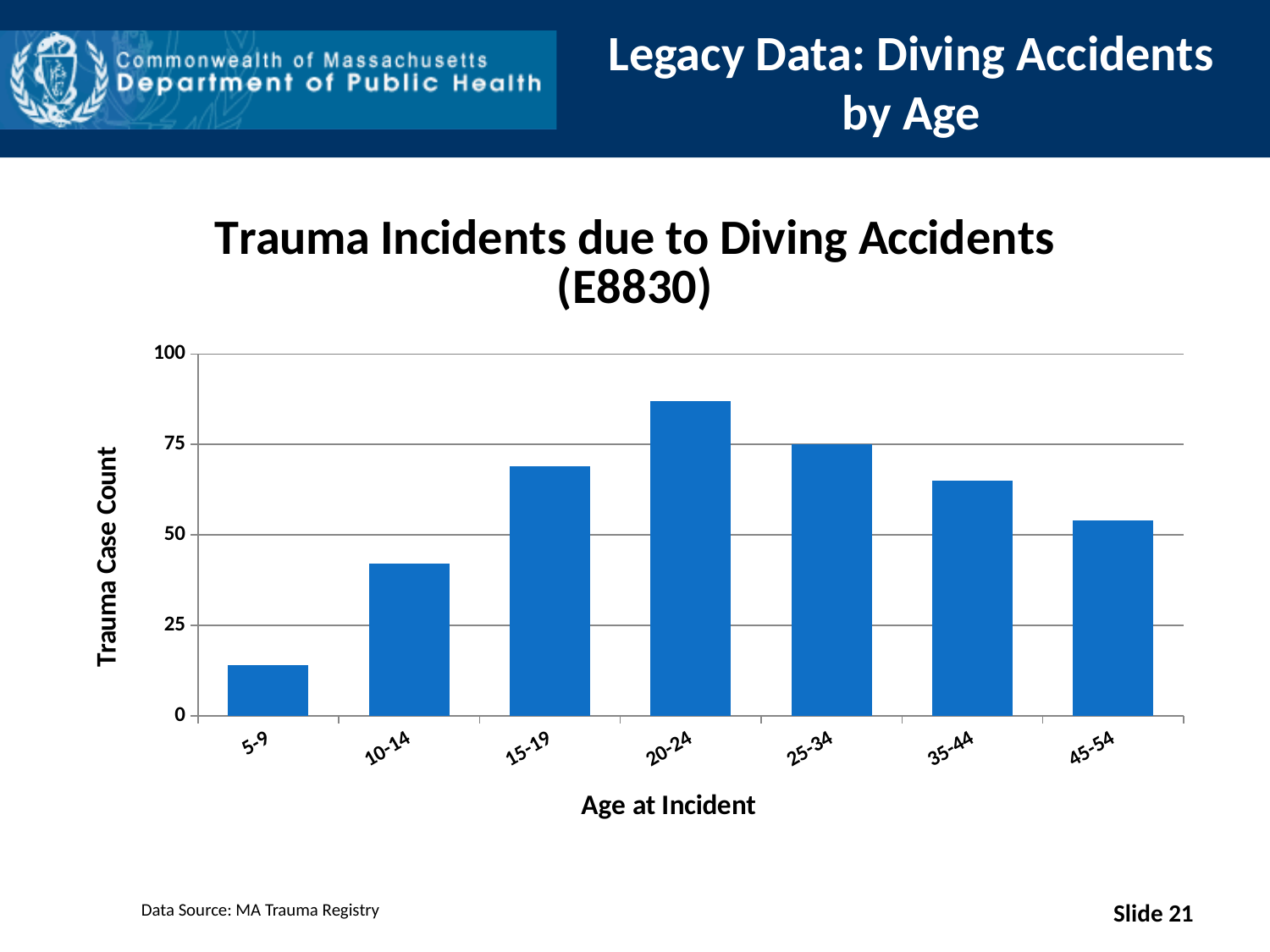
Is the trauma case count for the 10-14 age group greater or less than 50? less Do the trauma case counts rise or fall from the 20-24 age group to the 45-54 age group? fall Is the trauma case count for the 20-24 age group greater or less than 75? greater Which age group has the highest trauma case count? 20-24 Is the trauma case count for the 5-9 age group greater or less than 25? less How many age groups are shown on the x axis of the chart? 7 What is the label of the y axis of the chart? Trauma Case Count Which age group has a higher trauma case count, 35-44 or 45-54? 35-44 Which age group has the lowest trauma case count? 5-9 Which age group has a higher trauma case count, 10-14 or 15-19? 15-19 What type of chart is shown on the slide? Bar chart